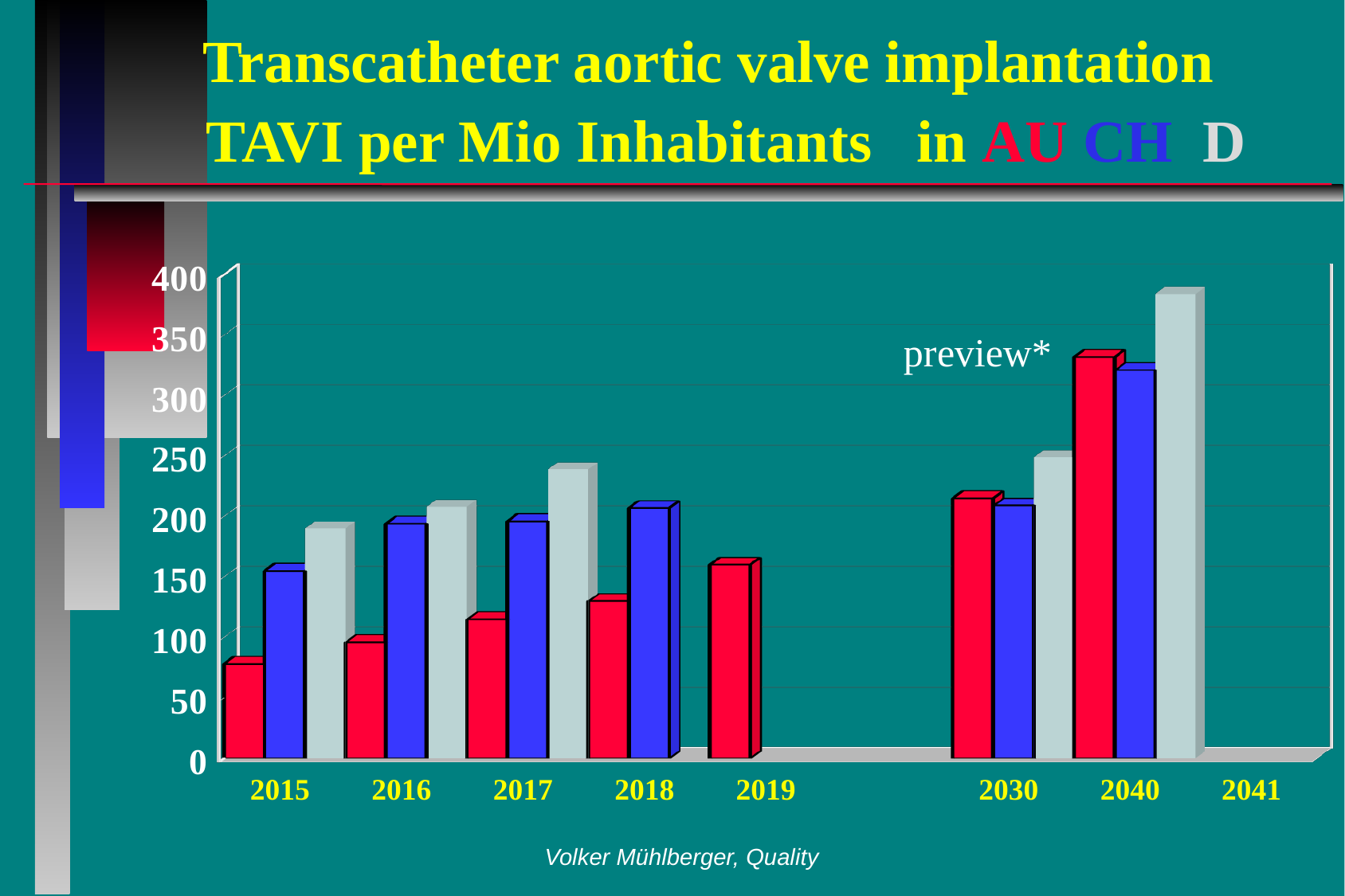
Which year has the tallest bar in the chart? 2040 Is the value for AU (red) in 2040 greater or less than 300? greater Is the value for D (grey) in 2040 greater or less than 350? greater Is the value for AU (red) in 2015 greater or less than 100? less Which year has the shortest bar in the chart? 2015 What annotation is written above the bars on the right side of the chart? preview* What kind of chart is shown on the slide? bar chart How many year labels are shown on the x axis? 8 Do the AU (red) values rise or fall from 2015 to 2019? rise In 2015, which is larger: the value for AU (red) or the value for D (grey)? D